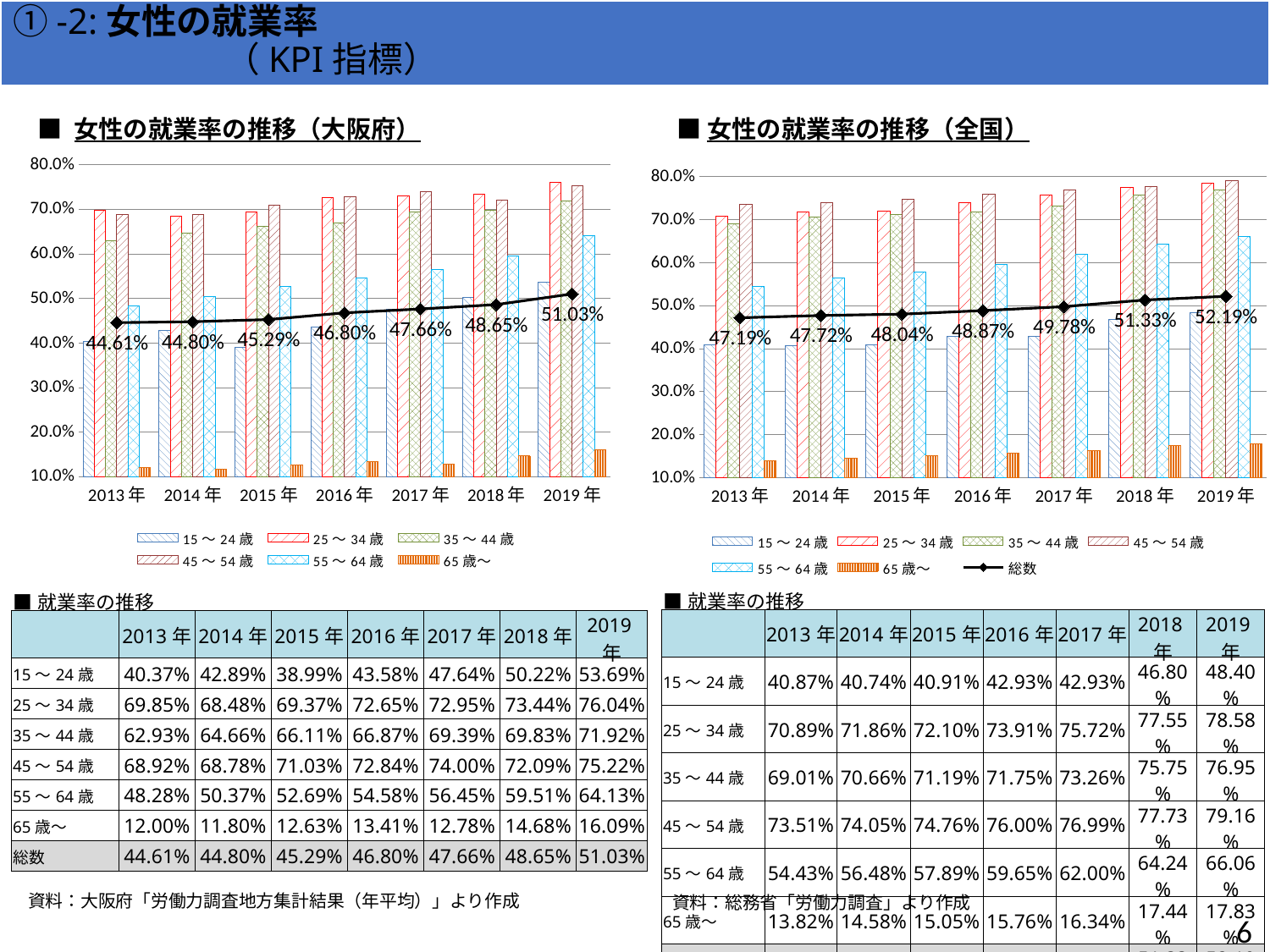
Comparing the 総数 values for 2016年, which chart shows the larger value: 大阪府 or 全国? 全国 How many years are shown on the x axis of the 女性の就業率の推移（全国） chart? 7 In the 女性の就業率の推移（大阪府） chart, does the 総数 line rise or fall from 2013年 to 2019年? rise In the 女性の就業率の推移（大阪府） chart, what is the 総数 value labelled for 2019年? 51.03% In the 女性の就業率の推移（大阪府） chart, is the value for 65歳～ in 2013年 greater or less than 20.0%? less In the 女性の就業率の推移（全国） chart, what is the difference between the 総数 values for 2019年 and 2018年? 0.86 How many series does the legend of the 女性の就業率の推移（全国） chart list? 7 What kind of chart is the 女性の就業率の推移（大阪府） chart? Combined bar and line chart In the 女性の就業率の推移（全国） chart, what is the 総数 value labelled for 2013年? 47.19% In the 女性の就業率の推移（全国） chart, is the value for 55～64歳 in 2019年 greater or less than 60.0%? greater In the 女性の就業率の推移（大阪府） chart, by how many percentage points did the 総数 value rise from 2013年 to 2019年? 6.42 In the 女性の就業率の推移（全国） chart, which year has the lowest 総数 value? 2013年